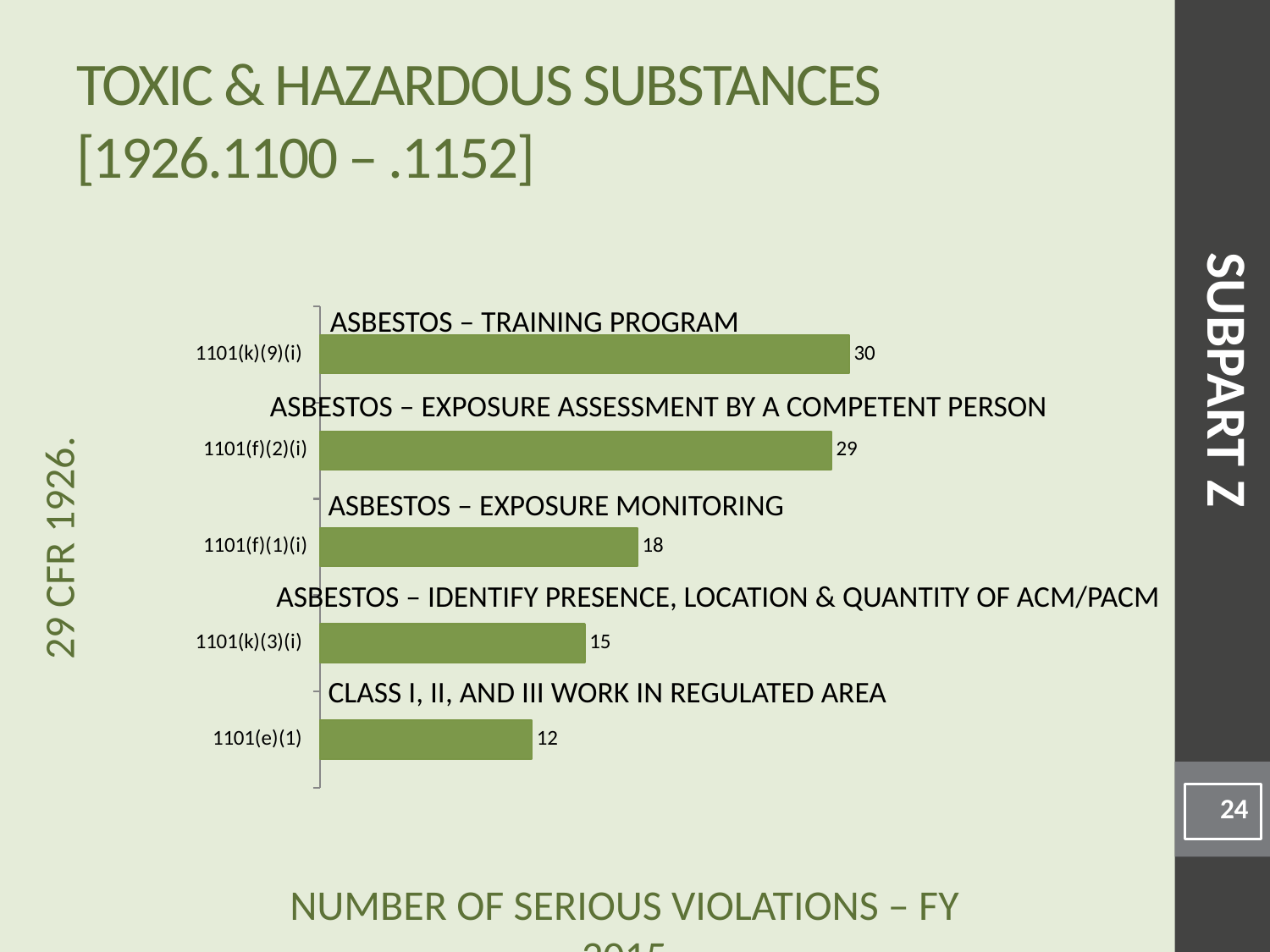
What is the number of serious violations for 1101(f)(1)(i)? 18 What is the total number of serious violations across all five categories? 104 What is the difference between the values for 1101(k)(9)(i) and 1101(e)(1)? 18 How many categories are shown in the chart? 5 What is the number of serious violations for 1101(f)(2)(i)? 29 What is the number of serious violations for 1101(k)(9)(i)? 30 Which has more serious violations, 1101(f)(1)(i) or 1101(k)(3)(i)? 1101(f)(1)(i) What is the difference between the values for 1101(f)(1)(i) and 1101(k)(3)(i)? 3 What is the number of serious violations for 1101(e)(1)? 12 Which category has the highest number of serious violations? 1101(k)(9)(i) Which category has the lowest number of serious violations? 1101(e)(1) What kind of chart is shown on the slide? bar chart